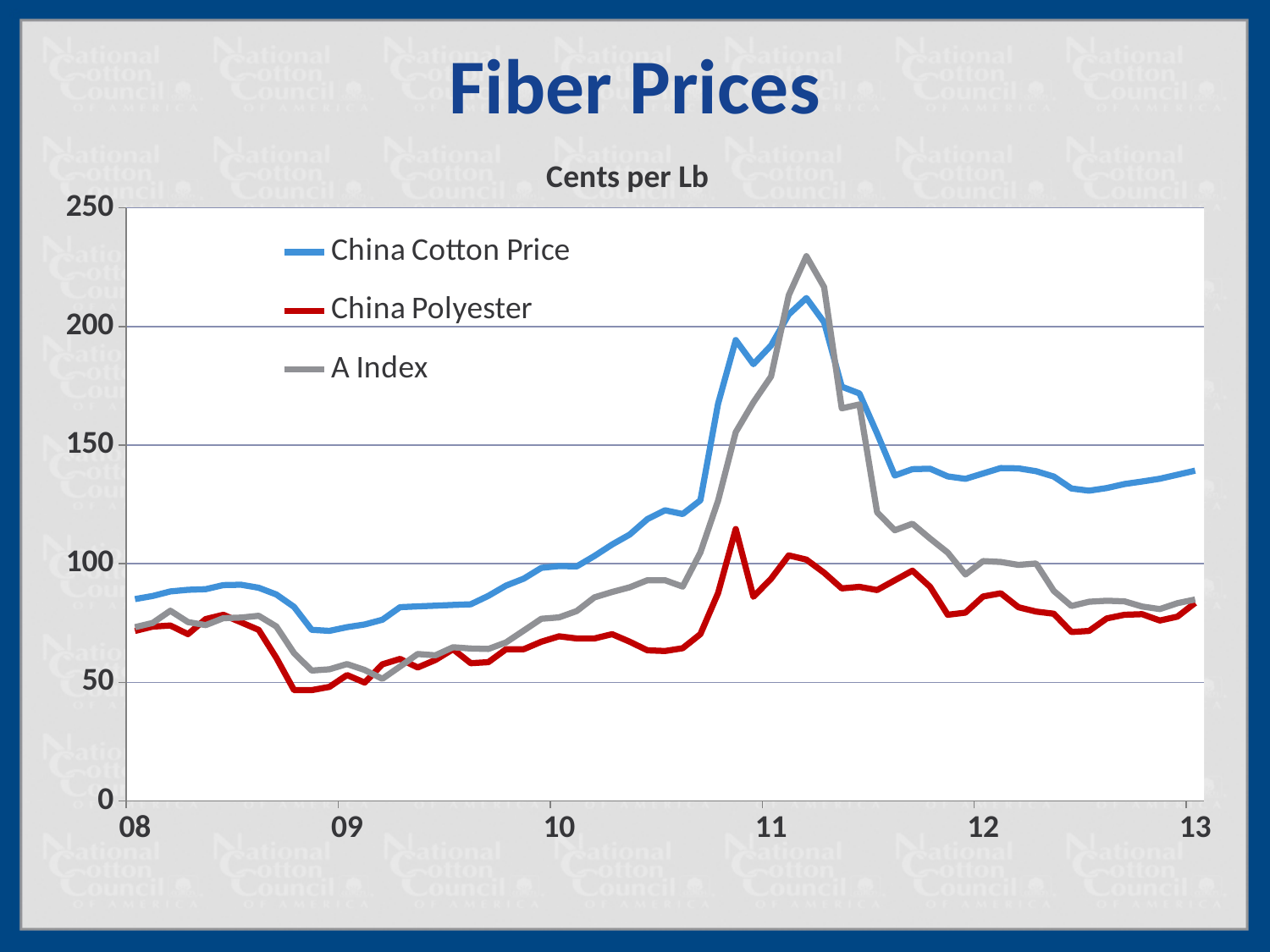
What is the title of the chart? Fiber Prices How many series does the legend list? 3 Is the peak value of the A Index around 11 greater or less than 200? greater Is the value for China Polyester at 08 greater or less than 100? less At 12, which is higher: China Cotton Price or A Index? China Cotton Price Which series reaches the highest peak on the chart? A Index Which series has the lowest value at 12? China Polyester Does the China Cotton Price rise or fall between 10 and 11? rise What unit is shown above the chart for the values? Cents per Lb Is the value for China Cotton Price at 13 greater or less than 100? greater At 13, which is higher: China Cotton Price or China Polyester? China Cotton Price What kind of chart is shown on the slide? line chart